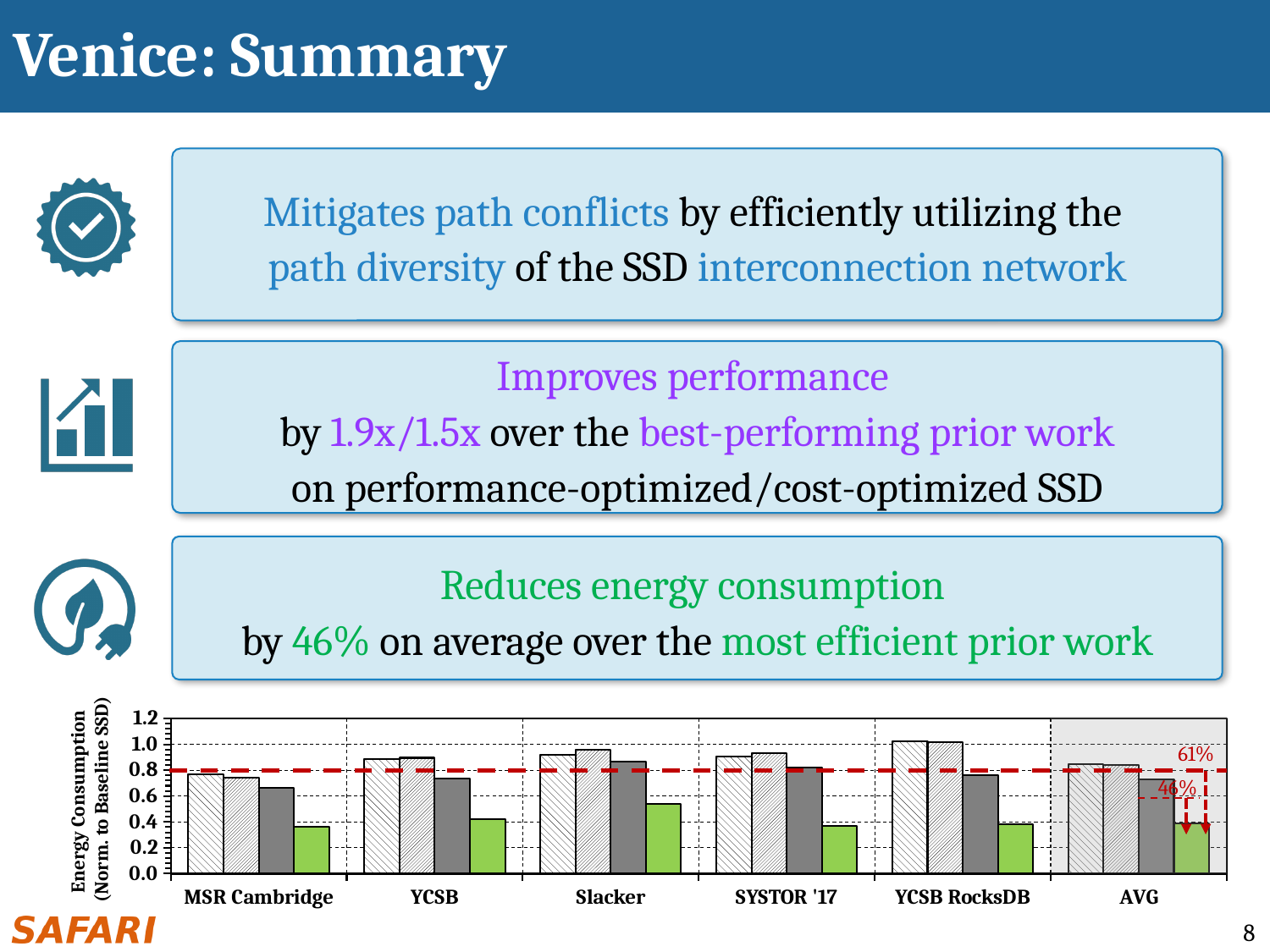
What kind of chart is shown at the bottom of the slide? Bar chart What two percentage annotations are shown above the AVG group in the chart? 61% and 46% Within each category, which bar is the lowest? The green (fourth) bar Which category contains the tallest bar in the chart? YCSB RocksDB What is the y-axis label of the chart? Energy Consumption (Norm. to Baseline SSD) How many bars are plotted for each category in the chart? 4 Is the green bar for Slacker greater or less than 0.4? greater Is the green bar for MSR Cambridge greater or less than 0.4? less Which is larger, the green bar for Slacker or the green bar for MSR Cambridge? Slacker Is the first (leftmost) bar for YCSB RocksDB greater or less than 0.8? greater How many workload categories are shown on the x axis of the chart? 6